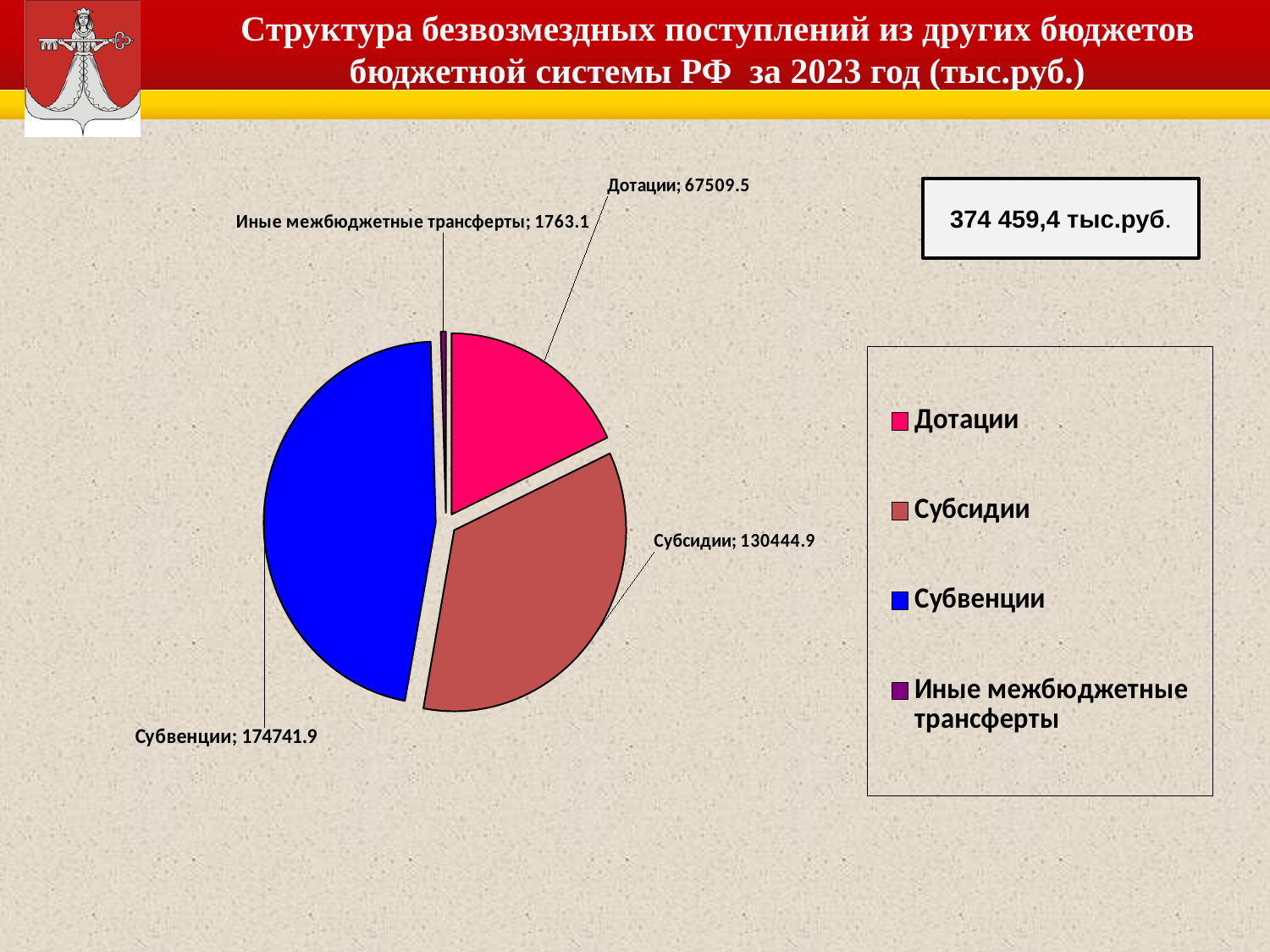
What kind of chart is shown on the slide? Pie chart Which category has the largest slice of the pie? Субвенции What is the value for Субвенции? 174741.9 How many categories does the pie chart show? 4 What is the value for Дотации? 67509.5 What is the difference between the values for Субвенции and Субсидии? 44297.0 What is the value for Иные межбюджетные трансферты? 1763.1 Which category has the smallest slice of the pie? Иные межбюджетные трансферты Which is larger, the value for Субсидии or the value for Дотации? Субсидии What is the value for Субсидии? 130444.9 What colour is the Субвенции slice in the pie chart? Blue What total amount is shown in the box at the top right of the slide? 374 459,4 тыс.руб.